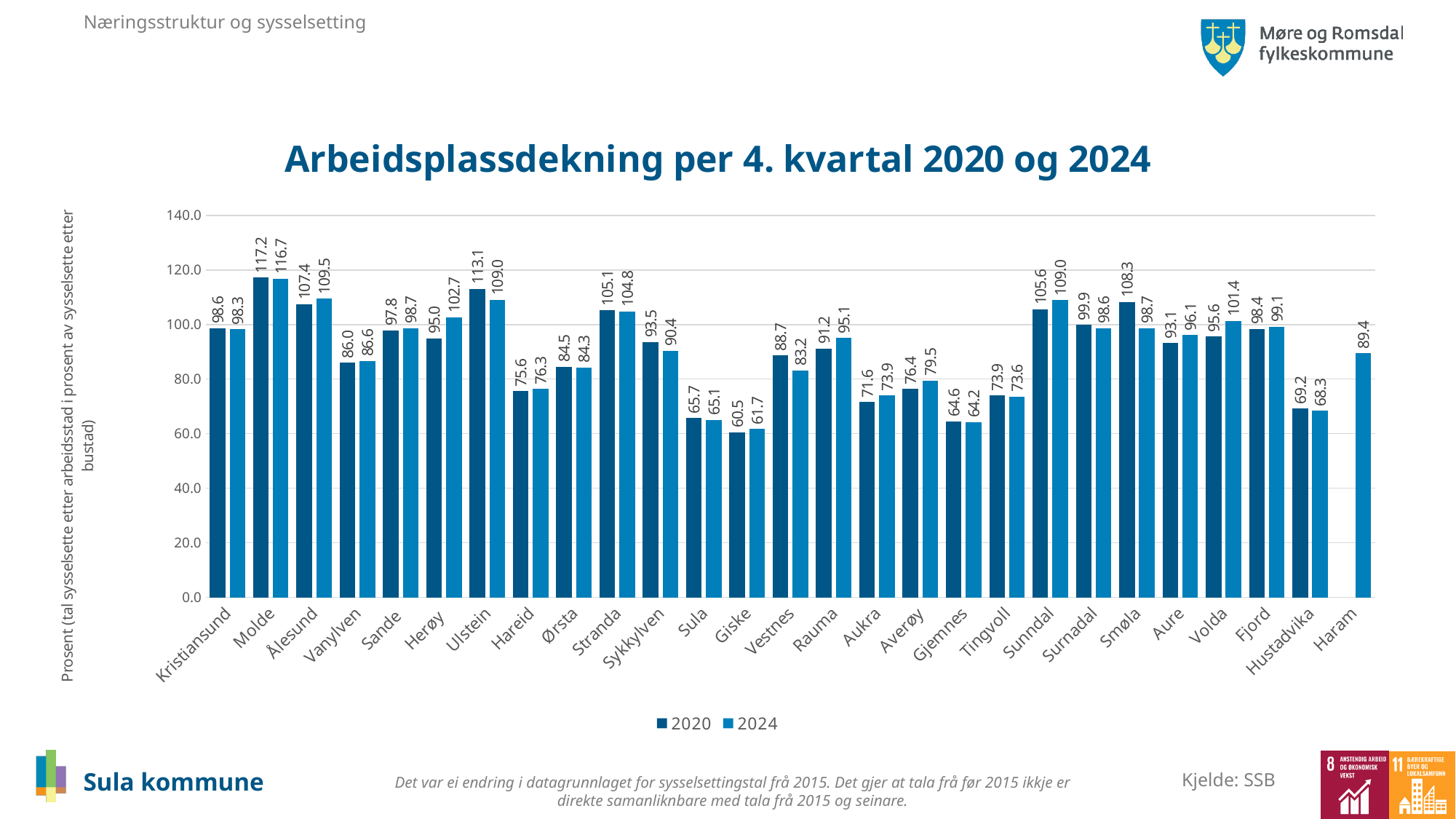
What is the 2020 value for Sula? 65.7 Which municipality has the lowest 2024 value? Giske What is the difference between the 2020 and 2024 values for Smøla? 9.6 Which municipality has a bar for 2024 only and no bar for 2020? Haram How many series does the legend list? 2 What is the 2024 value for Herøy? 102.7 What kind of chart is shown on the slide? Bar chart For Ulstein, which year has the larger value, 2020 or 2024? 2020 How many municipalities are shown on the x axis? 27 What is the 2024 value for Haram? 89.4 By how much did Herøy's value increase from 2020 to 2024? 7.7 Which municipality has the highest 2020 value? Molde